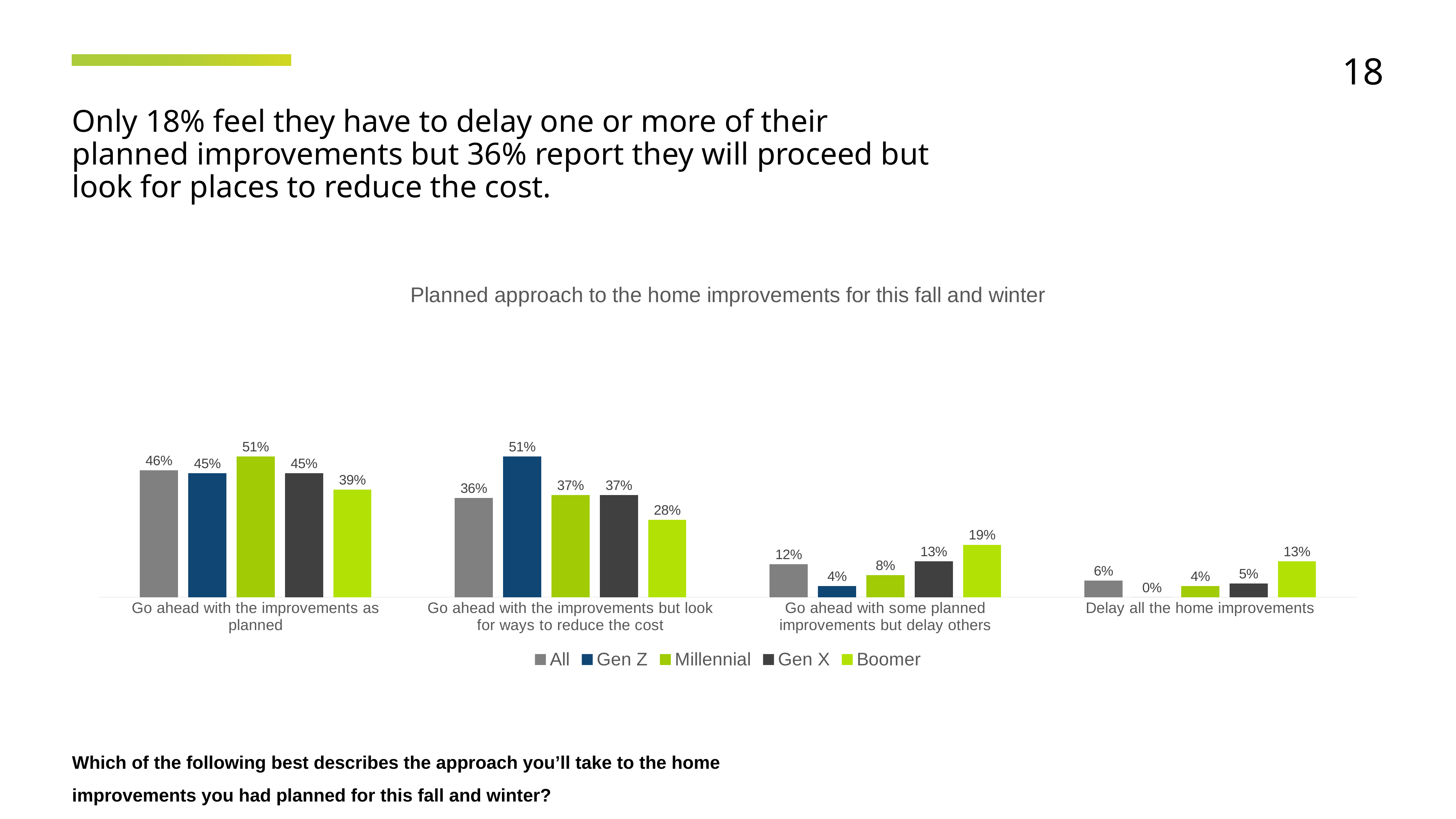
What is the value for Boomer in the 'Go ahead with some planned improvements but delay others' category? 19% Which series has the lowest value in the 'Go ahead with some planned improvements but delay others' category? Gen Z How many series does the legend list? 5 What is the value for All in the 'Go ahead with the improvements but look for ways to reduce the cost' category? 36% What is the title of the chart? Planned approach to the home improvements for this fall and winter How many categories are shown on the x axis? 4 What is the value for Gen Z in the 'Delay all the home improvements' category? 0% Which is larger: the Boomer value for 'Go ahead with the improvements as planned' or the Boomer value for 'Go ahead with the improvements but look for ways to reduce the cost'? Go ahead with the improvements as planned What is the value for Millennial in the 'Go ahead with the improvements as planned' category? 51% Which series has the highest value in the 'Go ahead with the improvements but look for ways to reduce the cost' category? Gen Z What is the difference between the Gen Z and Boomer values in the 'Go ahead with the improvements but look for ways to reduce the cost' category? 23% What kind of chart is shown on the slide? Bar chart